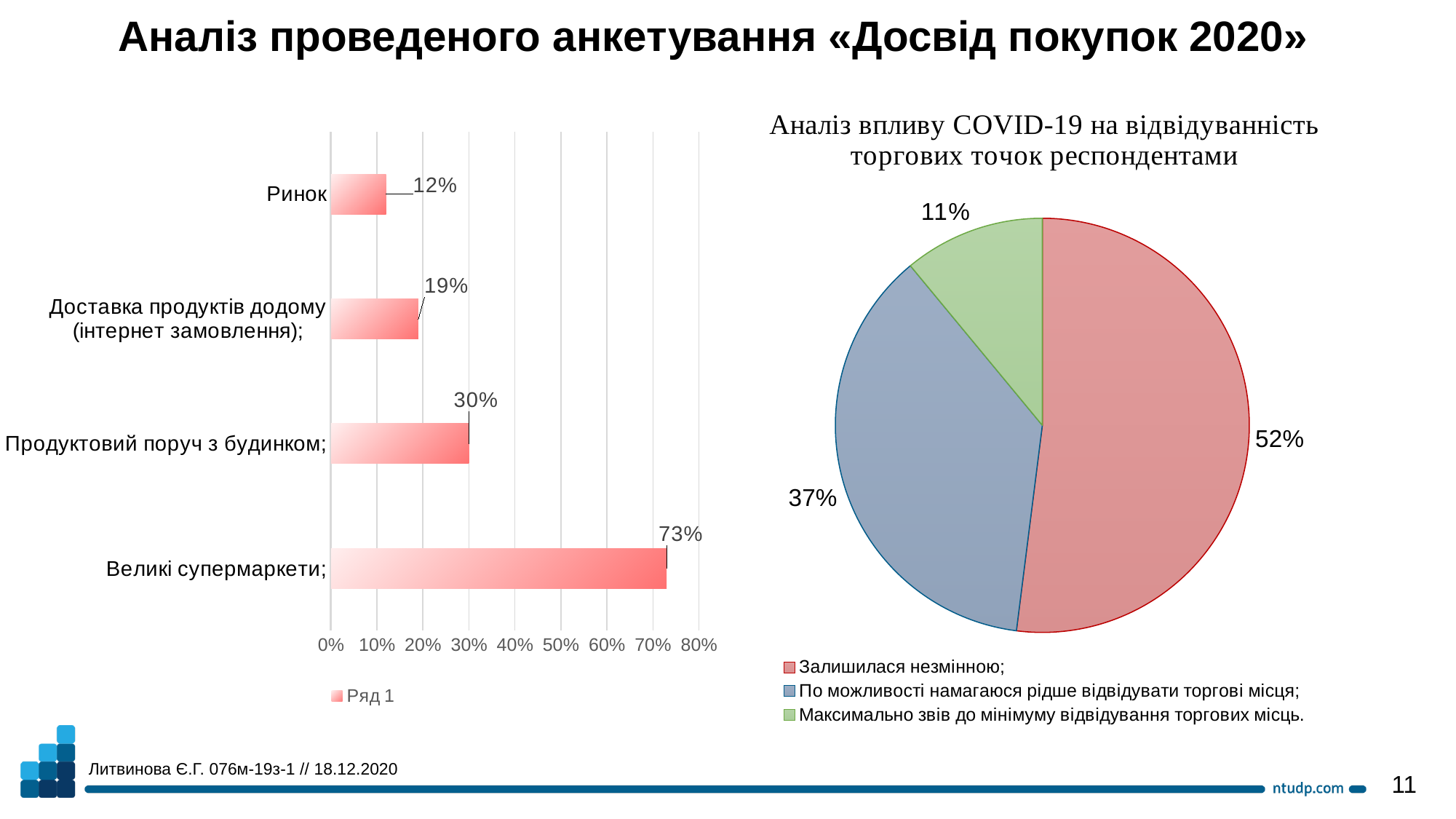
In the bar chart on the left, which category has the highest value? Великі супермаркети In the bar chart on the left, what is the value for Великі супермаркети? 73% In the pie chart 'Аналіз впливу COVID-19 на відвідуваність торгових точок респондентами', how many entries does the legend list? 3 In the bar chart on the left, what is the difference between Продуктовий поруч з будинком and Доставка продуктів додому (інтернет замовлення)? 11% In the bar chart on the left, what is the value for Ринок? 12% In the bar chart on the left, how many categories are shown? 4 What type of chart is on the left side of the slide? bar chart In the pie chart 'Аналіз впливу COVID-19 на відвідуваність торгових точок респондентами', what share does 'Залишилася незмінною' have? 52% In the pie chart 'Аналіз впливу COVID-19 на відвідуваність торгових точок респондентами', which slice is the largest? Залишилася незмінною In the pie chart 'Аналіз впливу COVID-19 на відвідуваність торгових точок респондентами', which is larger: 'По можливості намагаюся рідше відвідувати торгові місця' or 'Максимально звів до мінімуму відвідування торгових місць'? По можливості намагаюся рідше відвідувати торгові місця In the bar chart on the left, which category has the lowest value? Ринок In the pie chart 'Аналіз впливу COVID-19 на відвідуваність торгових точок респондентами', what is the value for 'Максимально звів до мінімуму відвідування торгових місць'? 11%